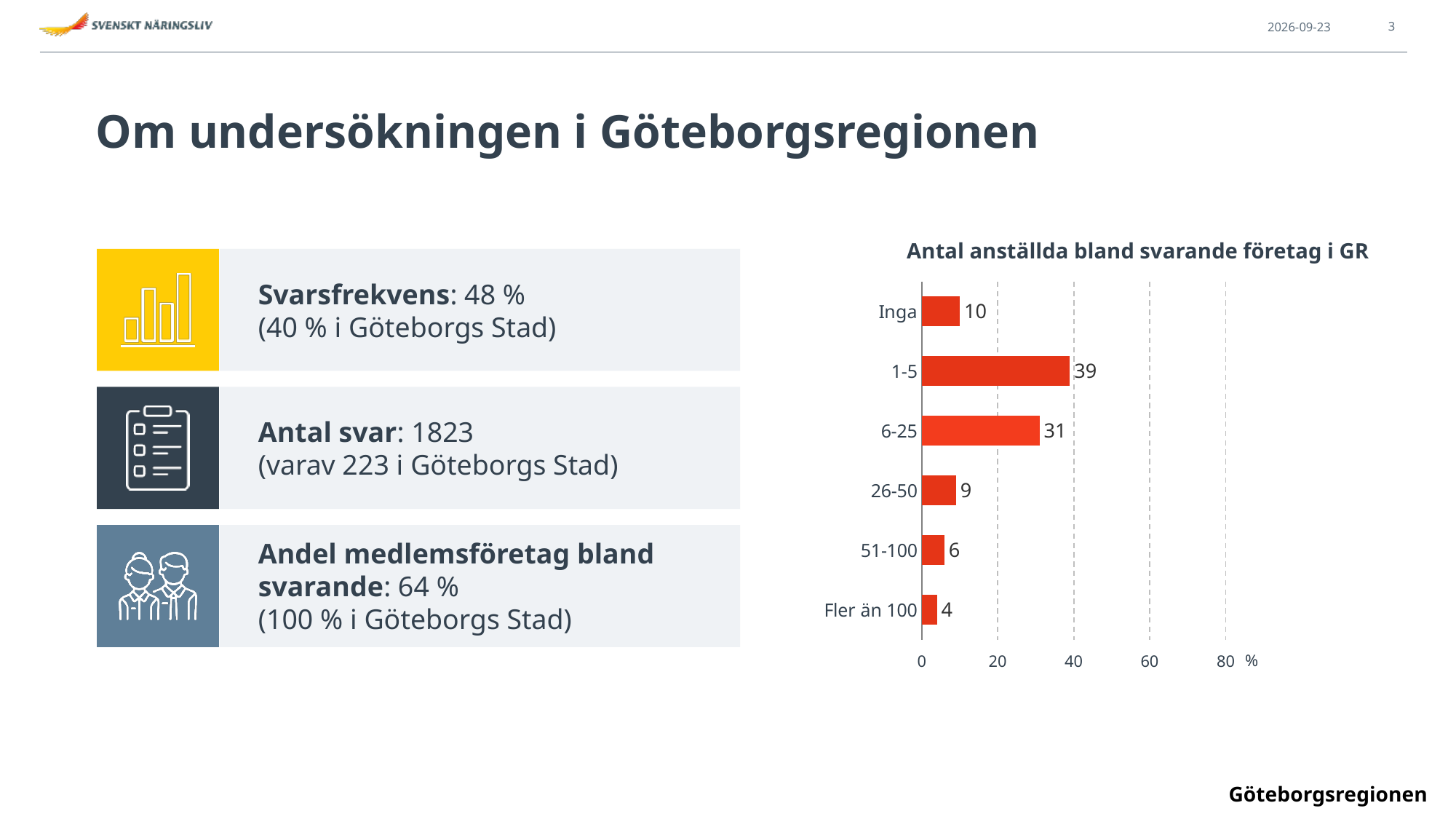
What kind of chart is shown on the slide? Bar chart What is the difference between the values for '51-100' and 'Fler än 100'? 2 What is the value for the 'Inga' category? 10 What is the title of the chart? Antal anställda bland svarande företag i GR Which category has the highest value? 1-5 Is the value for '6-25' greater or less than 20? greater How many categories are shown in the chart? 6 What is the difference between the values for '1-5' and '6-25'? 8 What is the value for the 'Fler än 100' category? 4 Which category has the lowest value? Fler än 100 Which is larger, the value for 'Inga' or the value for '26-50'? Inga What is the value for the '1-5' category? 39